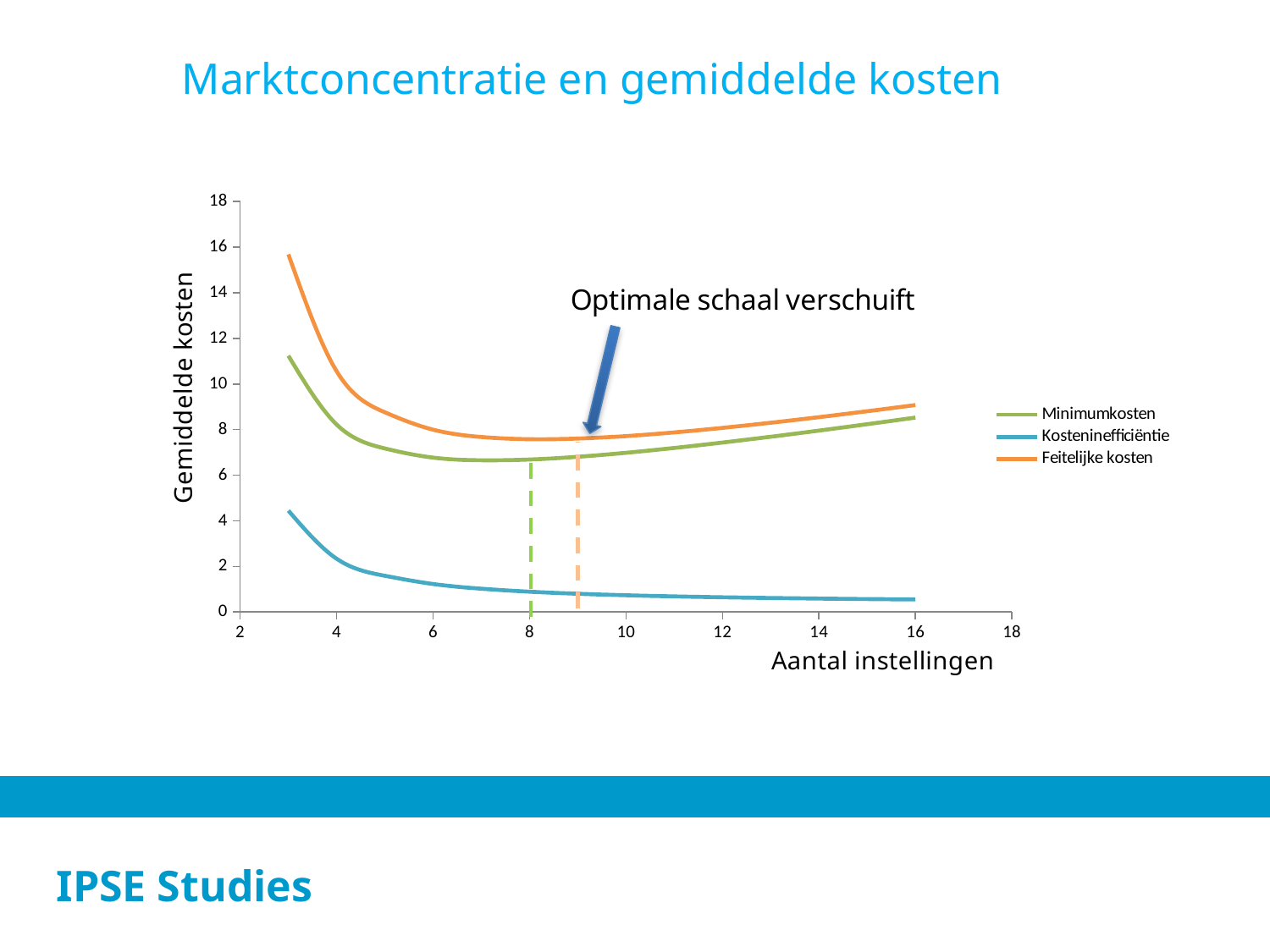
Does the Kosteninefficiëntie line rise or fall as the number of instellingen increases? fall At 3 instellingen, which is higher: Feitelijke kosten or Minimumkosten? Feitelijke kosten What kind of chart is shown on the slide? line chart How many series does the legend list? 3 Is the value of Minimumkosten at 3 instellingen greater or less than 10? greater Which series has the lowest values across the whole x axis? Kosteninefficiëntie Is the value of Feitelijke kosten at 3 instellingen greater or less than 14? greater Is the value of Kosteninefficiëntie at 16 instellingen greater or less than 2? less What is the title of the chart? Marktconcentratie en gemiddelde kosten What is the label of the x axis? Aantal instellingen